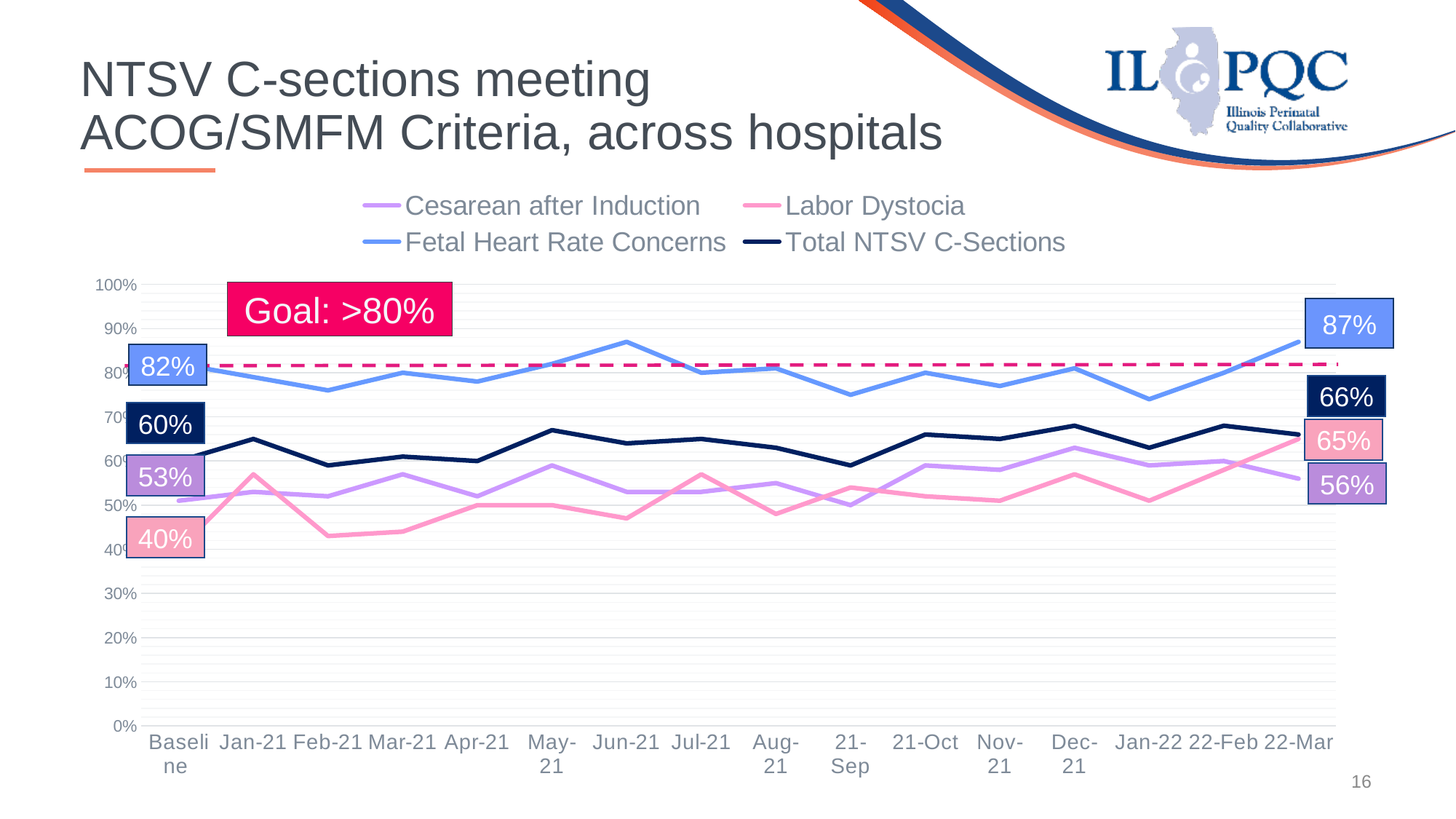
What is the value for Labor Dystocia at Baseline? 40% By how many percentage points did Labor Dystocia change from Baseline to 22-Mar? 25 percentage points What goal is shown on the chart? >80% What is the value for Total NTSV C-Sections at 22-Mar? 66% What kind of chart is shown on the slide? Line chart At Baseline, which is larger: Cesarean after Induction or Labor Dystocia? Cesarean after Induction Which series has the highest value at 22-Mar? Fetal Heart Rate Concerns What is the value for Fetal Heart Rate Concerns at Baseline? 82% Is the value for Fetal Heart Rate Concerns at Jan-22 greater or less than 80%? less What is the value for Cesarean after Induction at 22-Mar? 56% What is the value for Fetal Heart Rate Concerns at 22-Mar? 87% How many series does the legend list? 4